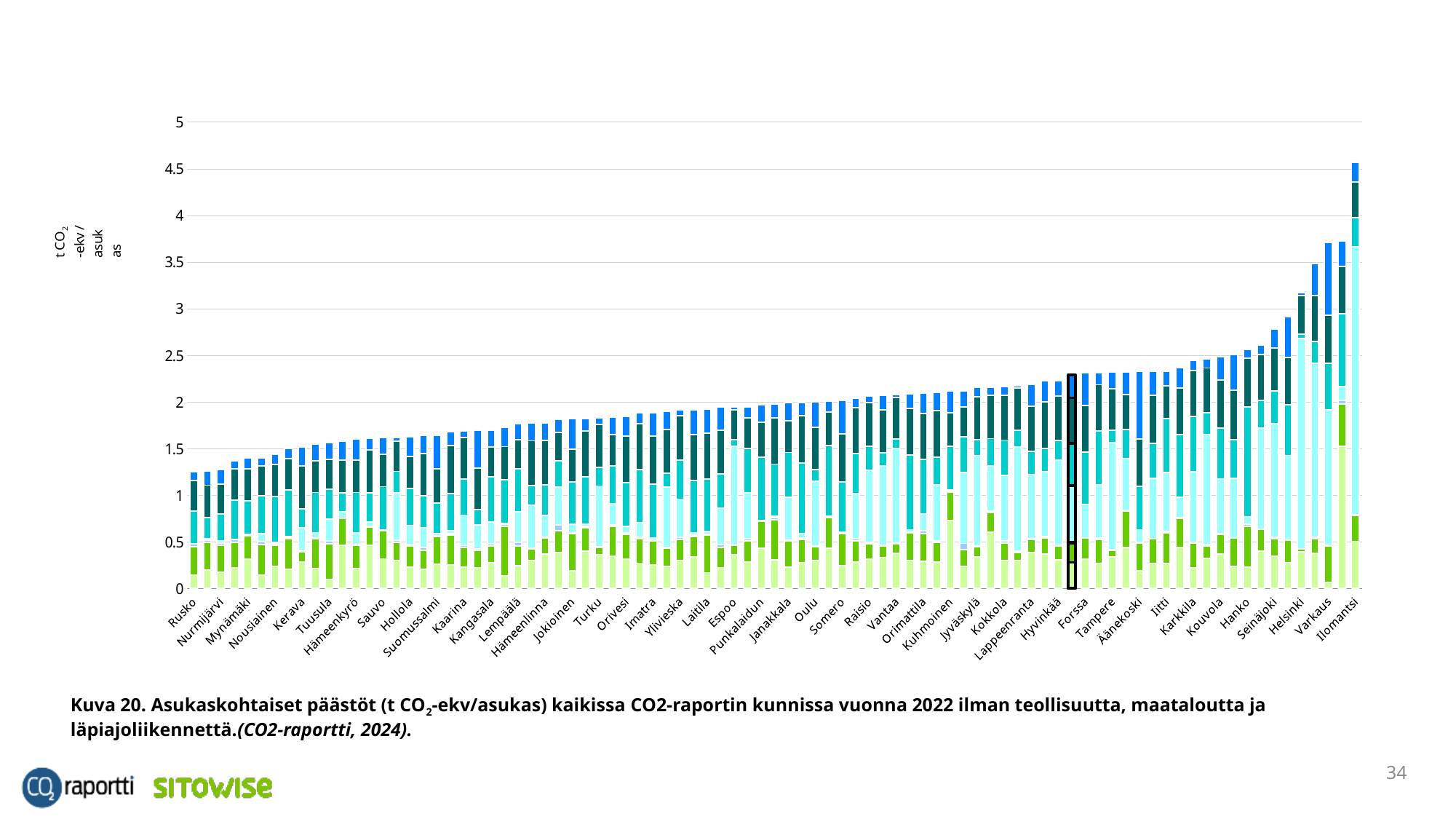
Do the total bar heights rise or fall from left to right along the x axis? Rise Which has the larger total value, Helsinki or Tampere? Helsinki Is the total value for Tampere greater or less than 2? greater Is the total value for Turku greater or less than 2? less Is the total value for Rusko greater or less than 1.5? less What kind of chart is shown on the slide? Stacked bar chart Which has the larger total value, Kerava or Kouvola? Kouvola Which municipality has the highest total emissions per inhabitant in the chart? Ilomantsi